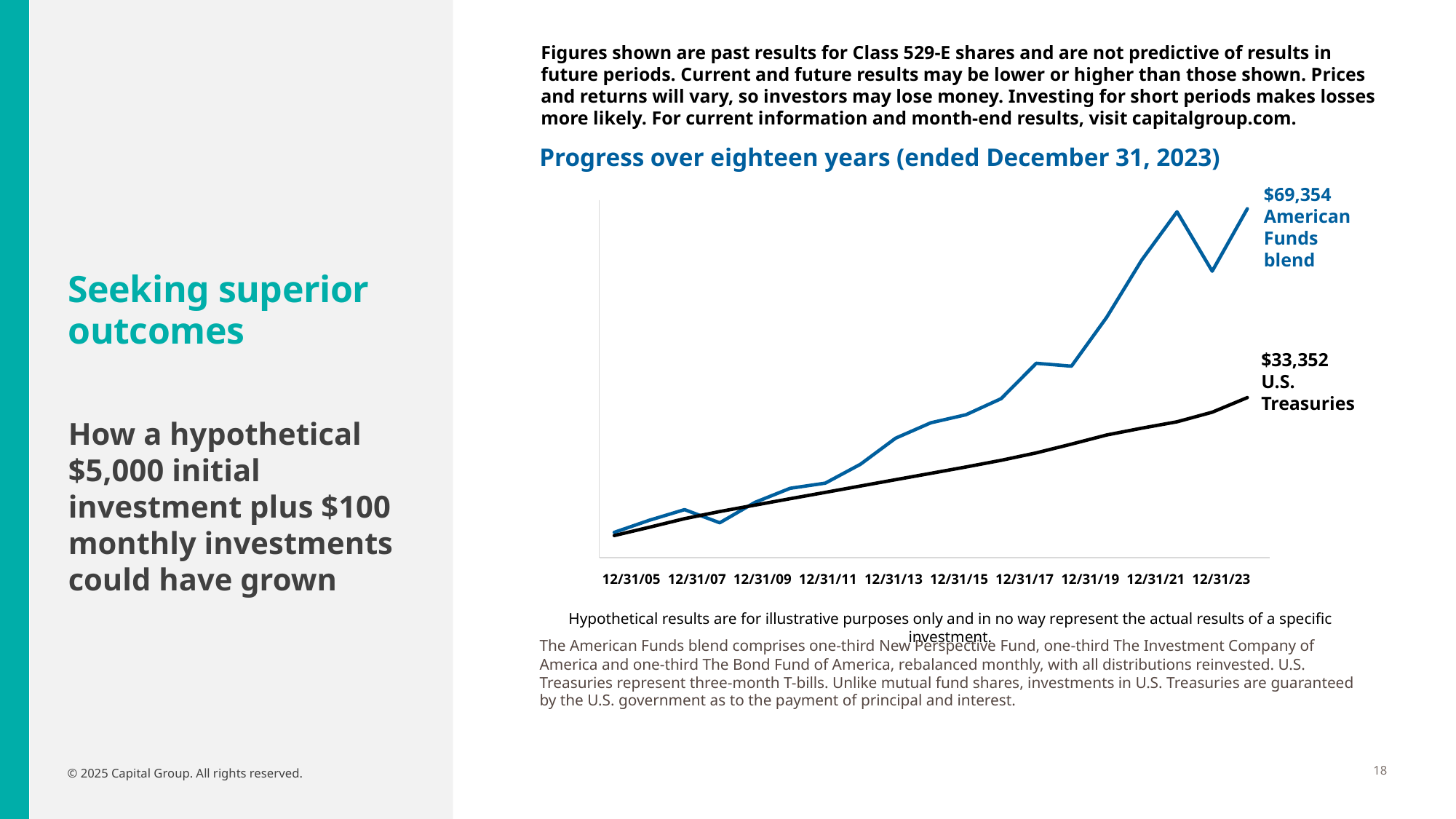
What colour is the line for the American Funds blend? Blue What is the first date label on the x axis? 12/31/05 How many series are plotted on the chart? 2 What type of chart is shown on the slide? Line chart What is the ending value of U.S. Treasuries at December 31, 2023? $33,352 Which series has the lowest ending value? U.S. Treasuries Which series ends with the higher value, American Funds blend or U.S. Treasuries? American Funds blend How many date labels are shown on the x axis? 10 What is the difference between the ending values of the American Funds blend and U.S. Treasuries? $36,002 What is the title of the chart? Progress over eighteen years (ended December 31, 2023) What is the ending value of the American Funds blend at December 31, 2023? $69,354 Does the U.S. Treasuries line rise or fall from 12/31/05 to 12/31/23? Rise